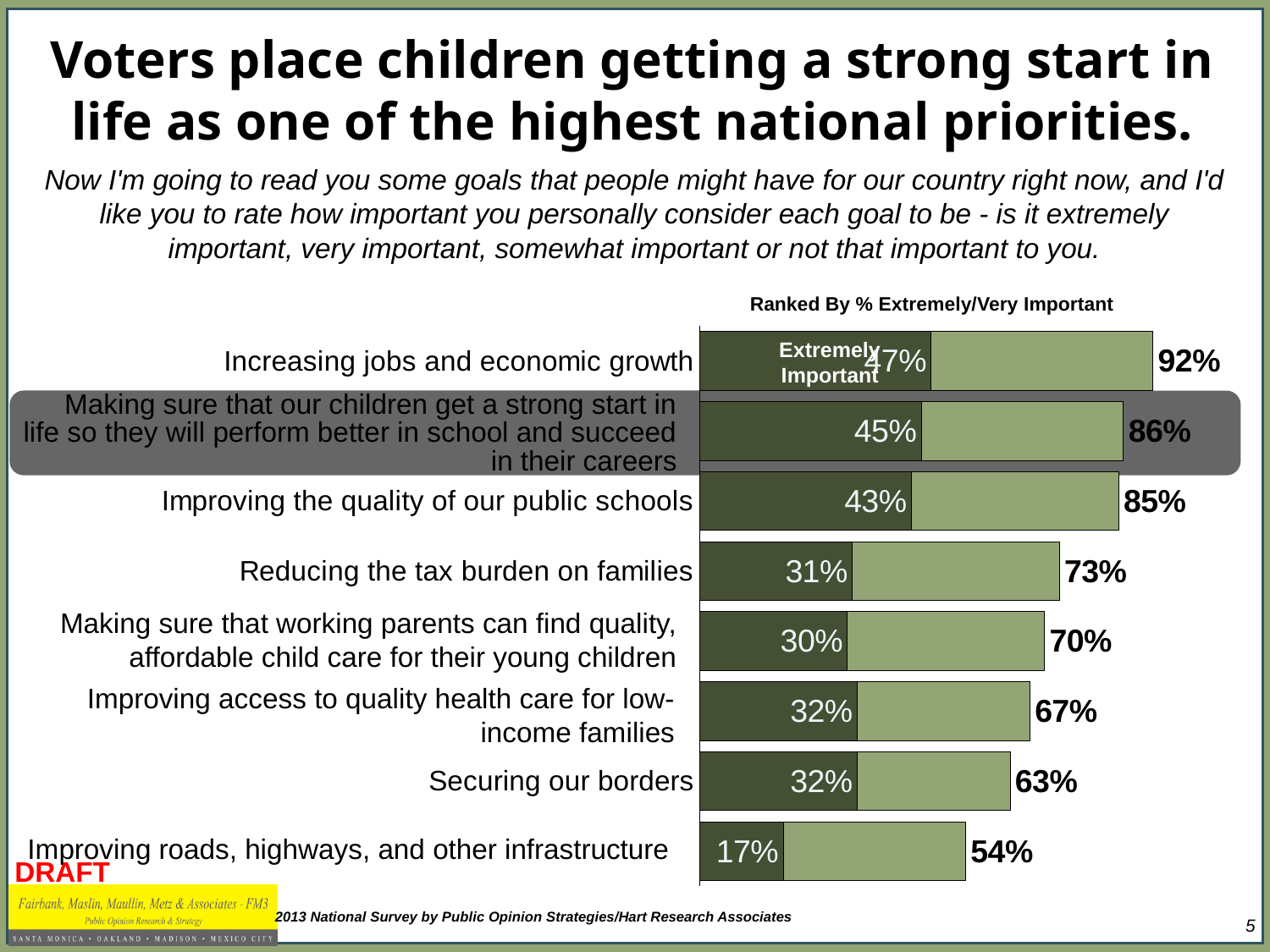
What is the difference in % Extremely/Very Important between 'Increasing jobs and economic growth' and 'Making sure that our children get a strong start in life'? 6 percentage points How many goals (categories) are plotted in the chart? 8 Which goal has the highest % Extremely/Very Important? Increasing jobs and economic growth Which goal has the lowest % Extremely/Very Important? Improving roads, highways, and other infrastructure What kind of chart is shown on the slide? bar chart What is the % Extremely/Very Important for 'Making sure that working parents can find quality, affordable child care for their young children'? 70% What percentage rate 'Securing our borders' as extremely important? 32% What percentage rate 'Making sure that our children get a strong start in life so they will perform better in school and succeed in their careers' as extremely important? 45% What percentage rate 'Reducing the tax burden on families' as extremely important? 31% Which has a higher % Extremely/Very Important: 'Securing our borders' or 'Improving access to quality health care for low-income families'? Improving access to quality health care for low-income families What is the % Extremely/Very Important for 'Improving the quality of our public schools'? 85% According to the label above the chart, what are the bars ranked by? % Extremely/Very Important